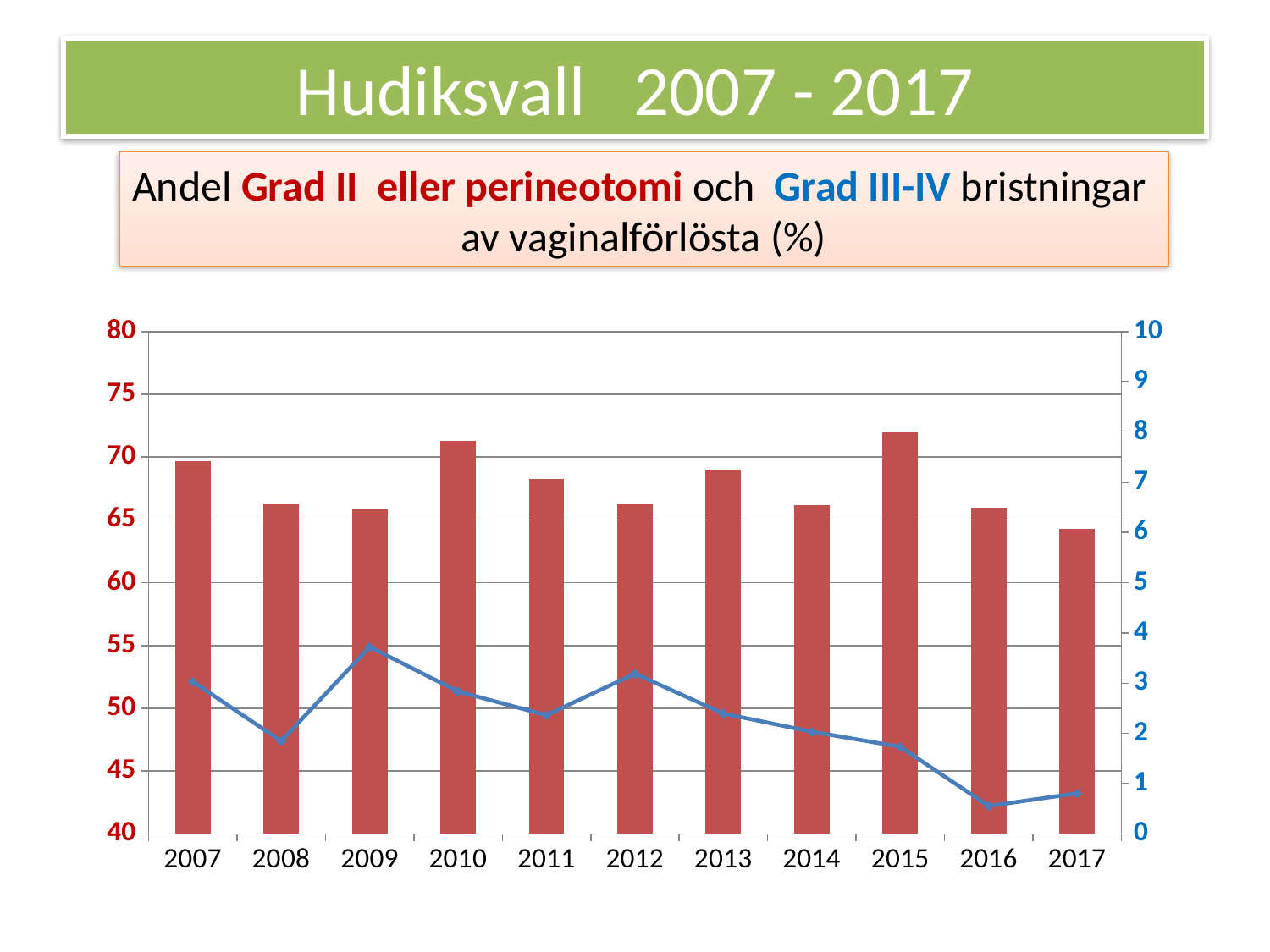
In which year does the blue line reach its highest point? 2009 Which year has the taller bar, 2007 or 2008? 2007 Which year has the lowest bar in the chart? 2017 What is the title shown in the green banner at the top of the slide? Hudiksvall 2007 - 2017 What kind of chart is shown on the slide? Combined bar and line chart Does the blue line generally rise or fall from 2012 to 2016? fall Is the bar value for 2017 greater or less than 65? less Is the blue line value for 2016 greater or less than 1 on the right axis? less How many years are shown on the x axis of the chart? 11 Is the bar value for 2010 greater or less than 70? greater Which year has the highest bar in the chart? 2015